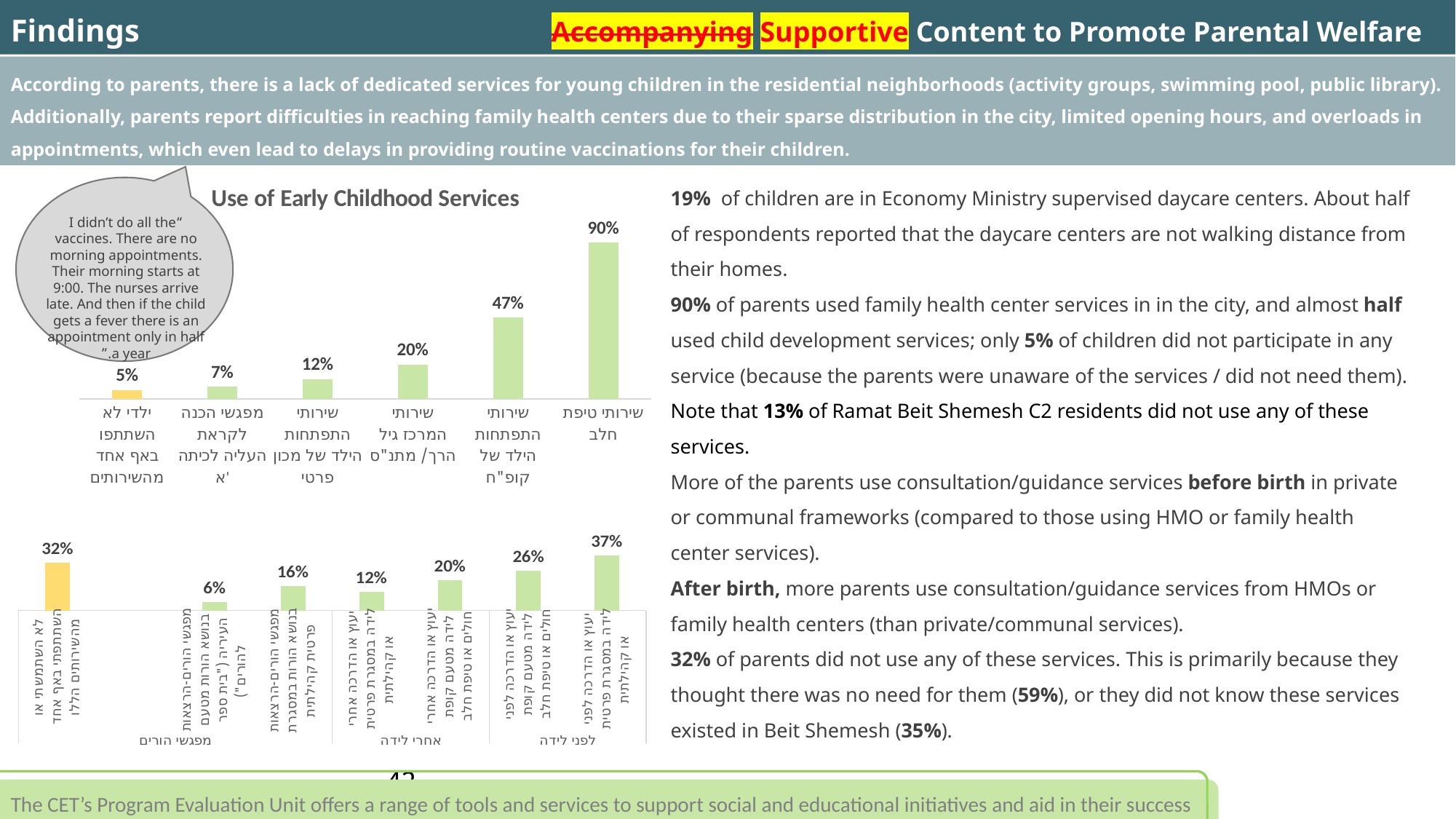
How many bars are in the bottom chart? 7 In the 'Use of Early Childhood Services' chart, what percentage is shown for שירותי התפתחות הילד של קופ"ח? 47% In the 'Use of Early Childhood Services' chart, do the values rise or fall from left to right? rise What type of chart is the 'Use of Early Childhood Services' chart? bar chart In the bottom chart, which is larger: the value for ייעוץ או הדרכה לפני לידה מטעם קופת חולים או טיפת חלב or the value for ייעוץ או הדרכה אחרי לידה מטעם קופת חולים או טיפת חלב? ייעוץ או הדרכה לפני לידה מטעם קופת חולים או טיפת חלב (26%) In the 'Use of Early Childhood Services' chart, what is the difference between the values for שירותי טיפת חלב and שירותי התפתחות הילד של קופ"ח? 43% In the bottom chart, which bar has the highest value? ייעוץ או הדרכה לפני לידה במסגרת פרטית או קהילתית (37%) How many bars are in the 'Use of Early Childhood Services' chart? 6 In the 'Use of Early Childhood Services' chart, which category has the lowest value? ילדי לא השתתפו באף אחד מהשירותים In the bottom chart, what percentage is shown for the bar labelled לא השתמשתי או השתתפתי באף אחד מהשירותים הללו? 32% In the bottom chart, what is the difference between the 37% bar and the 6% bar? 31% In the 'Use of Early Childhood Services' chart, what percentage is shown for שירותי טיפת חלב? 90%